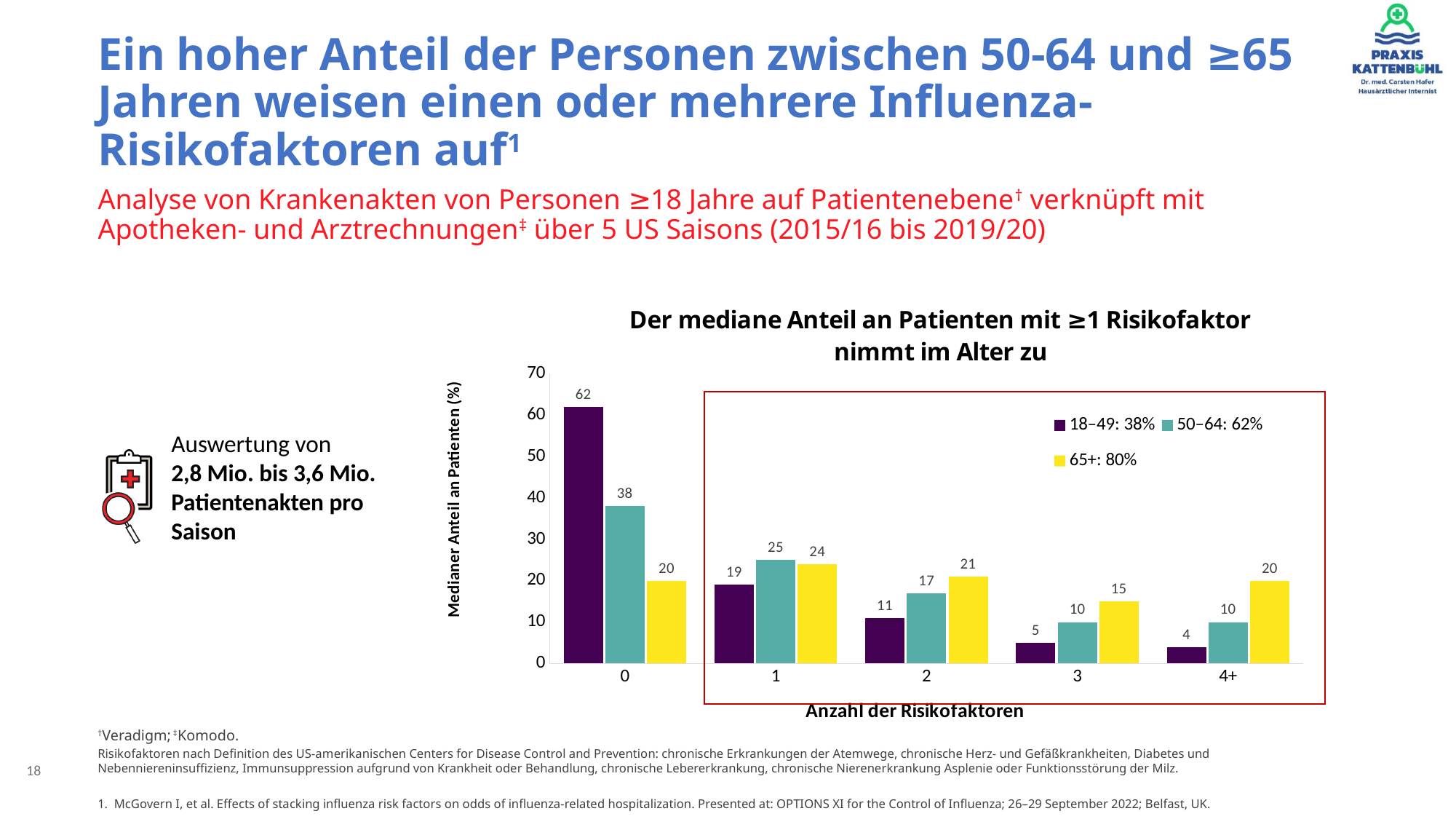
Which series has the highest value at 3 risk factors? 65+: 80% What is the value for the 18–49 series at 0 risk factors? 62 What is the value for the 50–64 series at 2 risk factors? 17 Do the values for the 18–49 series rise or fall as the number of risk factors increases from 0 to 4+? fall How many categories are shown on the x axis? 5 Which is larger at 1 risk factor: the 50–64 value or the 65+ value? 50–64 What is the label of the x axis? Anzahl der Risikofaktoren What is the value for the 65+ series at 4+ risk factors? 20 What kind of chart is shown on the slide? bar chart Which series has the lowest value at 4+ risk factors? 18–49: 38% How many series does the legend list? 3 What is the difference between the 18–49 and 50–64 values at 0 risk factors? 24